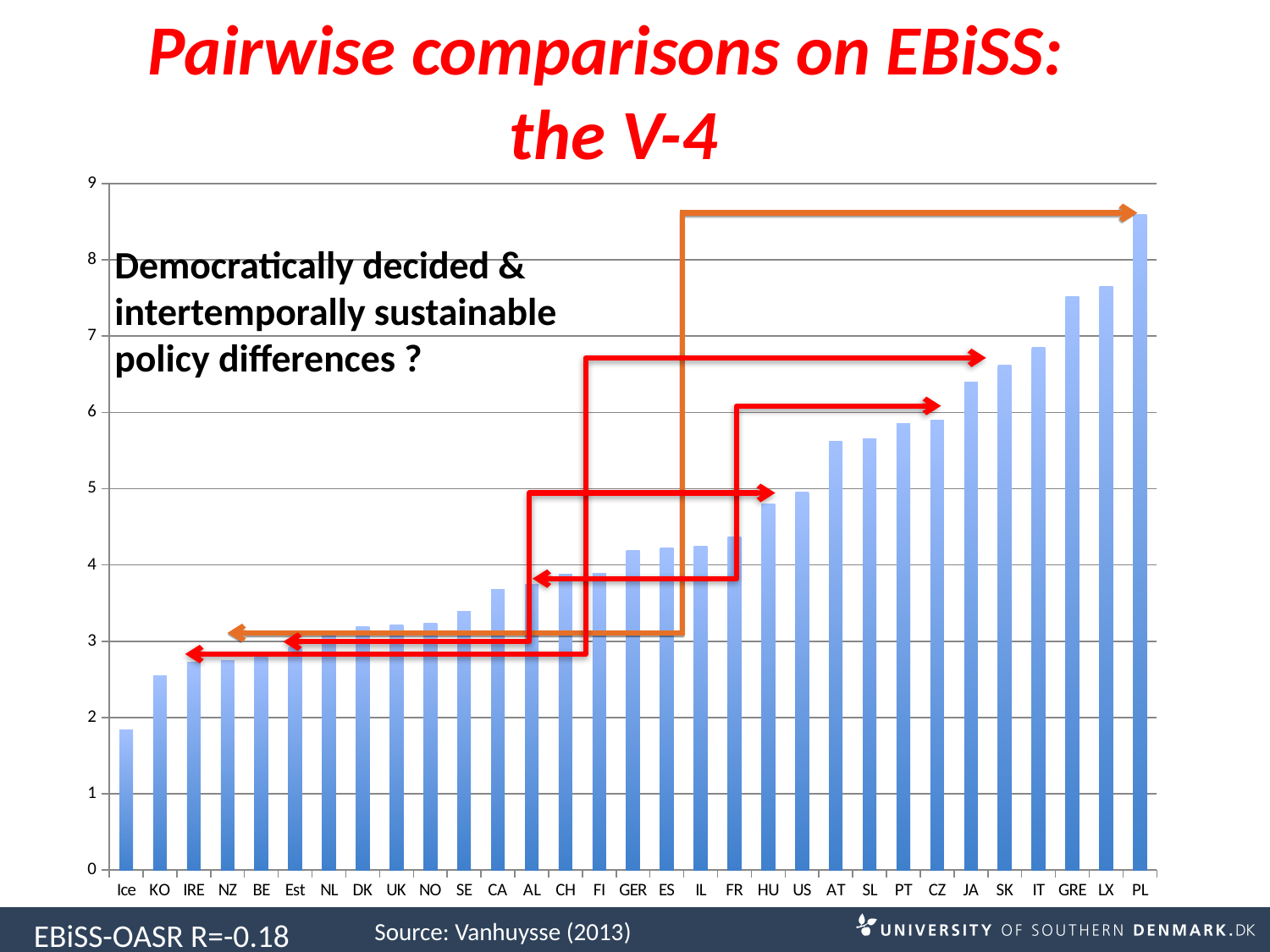
Which has the larger value, KO or CA? CA Is the value for HU greater or less than 5? less What is the title of the slide containing the chart? Pairwise comparisons on EBiSS: the V-4 Is the value for Ice greater or less than 2? less What kind of chart is shown on the slide? bar chart Which country has the highest value in the chart? PL Do the values rise or fall moving from left to right along the x axis? rise Is the value for PL greater or less than 8? greater Which country has the lowest value in the chart? Ice How many countries (categories) are plotted on the x axis? 31 Which has the larger value, GRE or SK? GRE